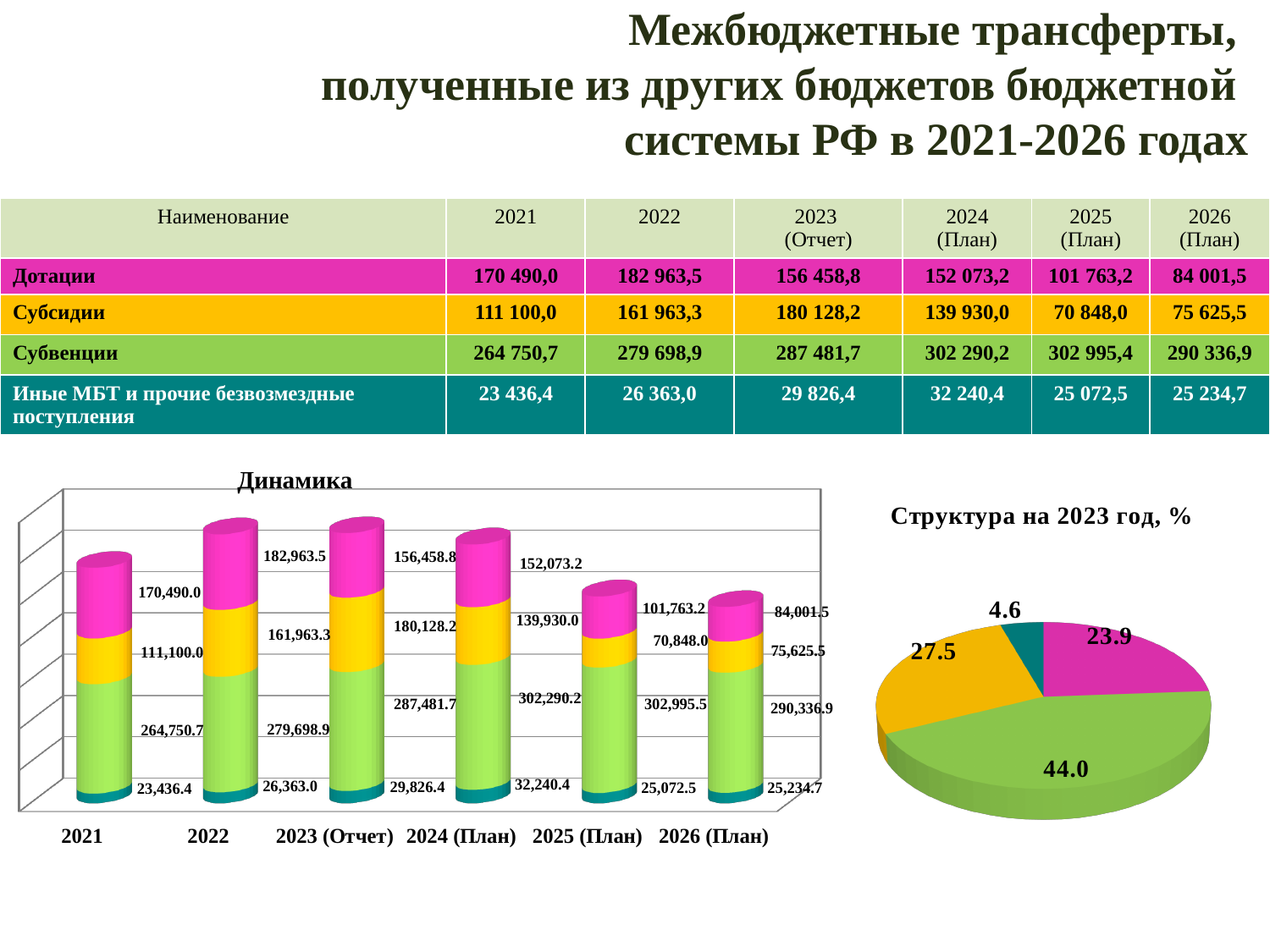
In the 'Динамика' chart, which year has the highest value for the yellow segment? 2023 (Отчет) In the 'Динамика' chart, what is the value printed on the teal bottom segment of the 2026 (План) bar? 25,234.7 How many years (bars) are shown in the 'Динамика' chart? 6 In the 'Динамика' chart, which is larger: the yellow segment for 2022 or the yellow segment for 2025 (План)? 2022 In the pie chart 'Структура на 2023 год, %', what is the value of the smallest slice? 4.6 In the 'Динамика' chart, which year has the lowest value for the pink segment? 2026 (План) In the 'Динамика' chart, what is the total of the 2021 stacked bar? 569,777.1 In the pie chart 'Структура на 2023 год, %', which slice is the largest and what is its value? The green slice, 44.0 In the 'Динамика' chart, what is the value printed on the pink top segment of the 2021 bar? 170,490.0 In the 'Динамика' chart, what is the value printed on the green segment of the 2024 (План) bar? 302,290.2 What kind of chart is the 'Динамика' chart? Stacked bar chart In the 'Динамика' chart, what is the difference between the pink segment values for 2023 (Отчет) and 2024 (План)? 4,385.6